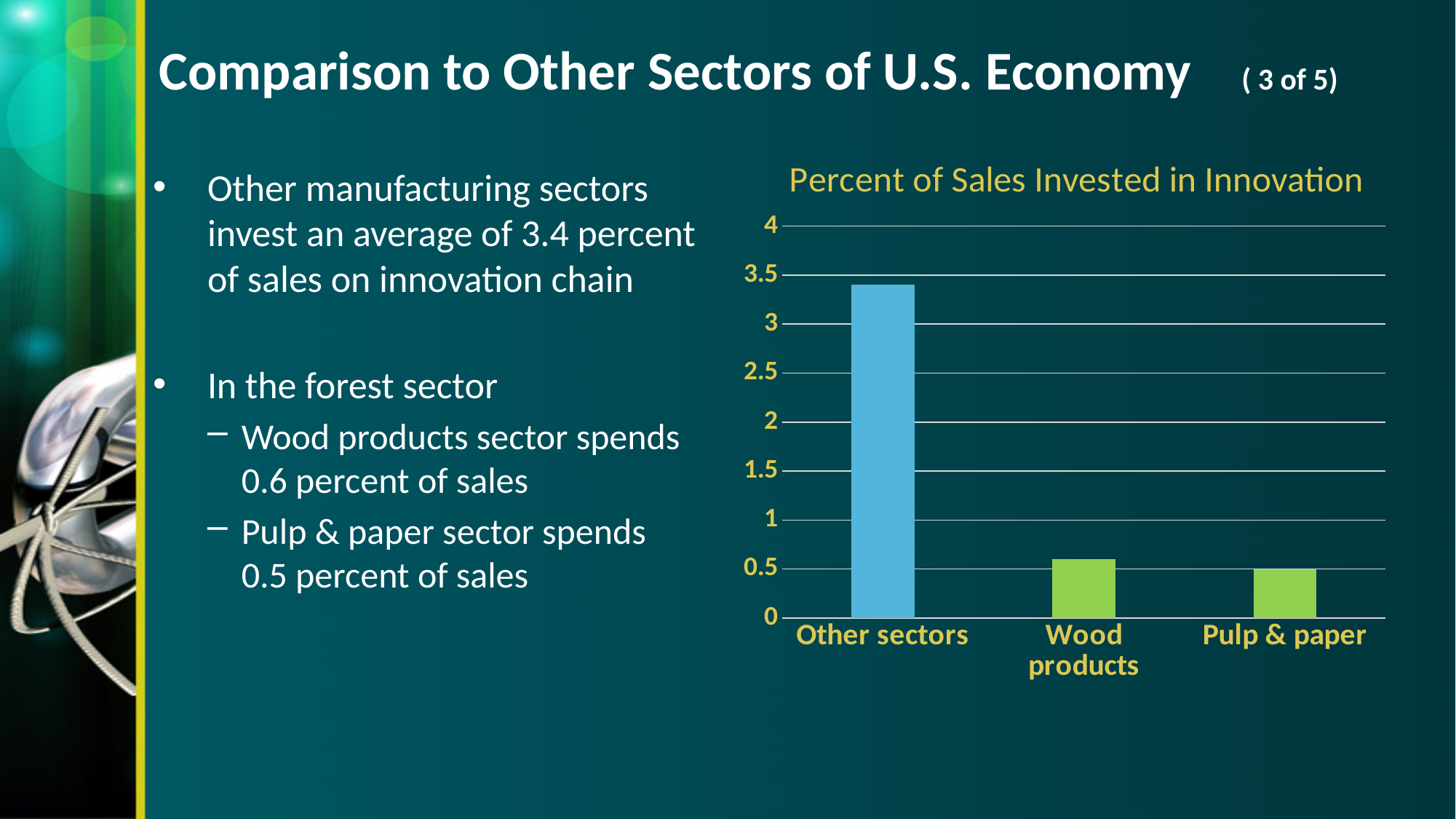
Which category has the highest value in the chart? Other sectors How many categories are plotted in the chart? 3 What is the value for Pulp & paper in the chart? 0.5 Is the value for Other sectors greater or less than 3? greater Is the value for Wood products greater or less than 1? less What colour is the bar for Other sectors? blue Which is larger, the value for Other sectors or the value for Wood products? Other sectors What kind of chart is shown on the slide? bar chart What is the title of the chart? Percent of Sales Invested in Innovation Which category has the lowest value in the chart? Pulp & paper Is the value for Other sectors greater or less than 3.5? less Do the values rise or fall moving from left to right along the x axis? fall